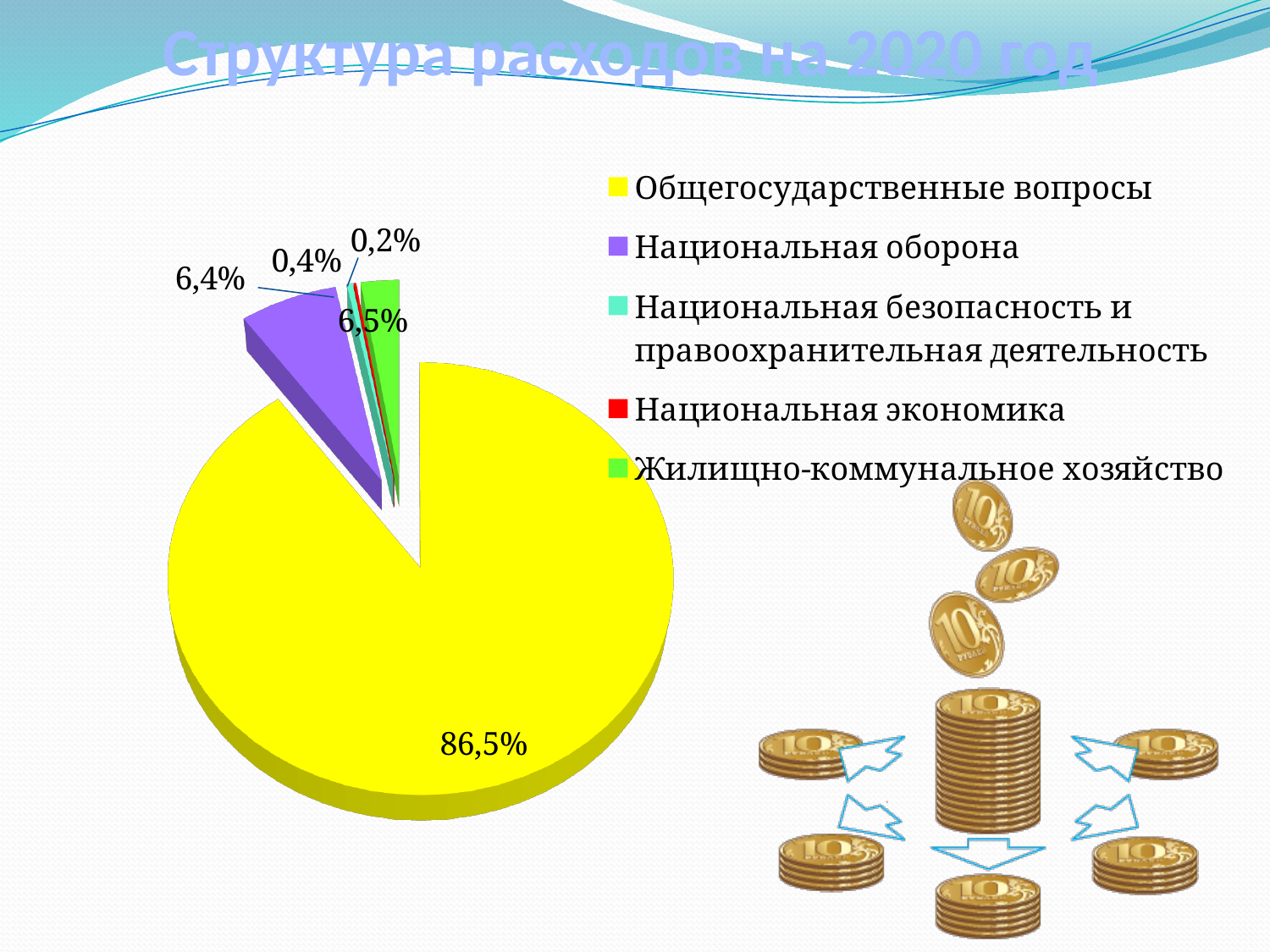
Which colour represents Национальная экономика in the legend? red What is the difference between the shares of Общегосударственные вопросы and Национальная оборона? 80,1% What kind of chart is shown on the slide? pie chart How many categories does the legend of the pie chart list? 5 Which category has the smallest share of the pie? Национальная экономика What is the value shown for Жилищно-коммунальное хозяйство? 6,5% What is the value shown for Национальная безопасность и правоохранительная деятельность? 0,4% What is the value shown for Национальная оборона? 6,4% Which category has the largest share of the pie? Общегосударственные вопросы What is the title of the chart on the slide? Структура расходов на 2020 год What share of the pie does Общегосударственные вопросы take? 86,5% What is the value shown for Национальная экономика? 0,2%